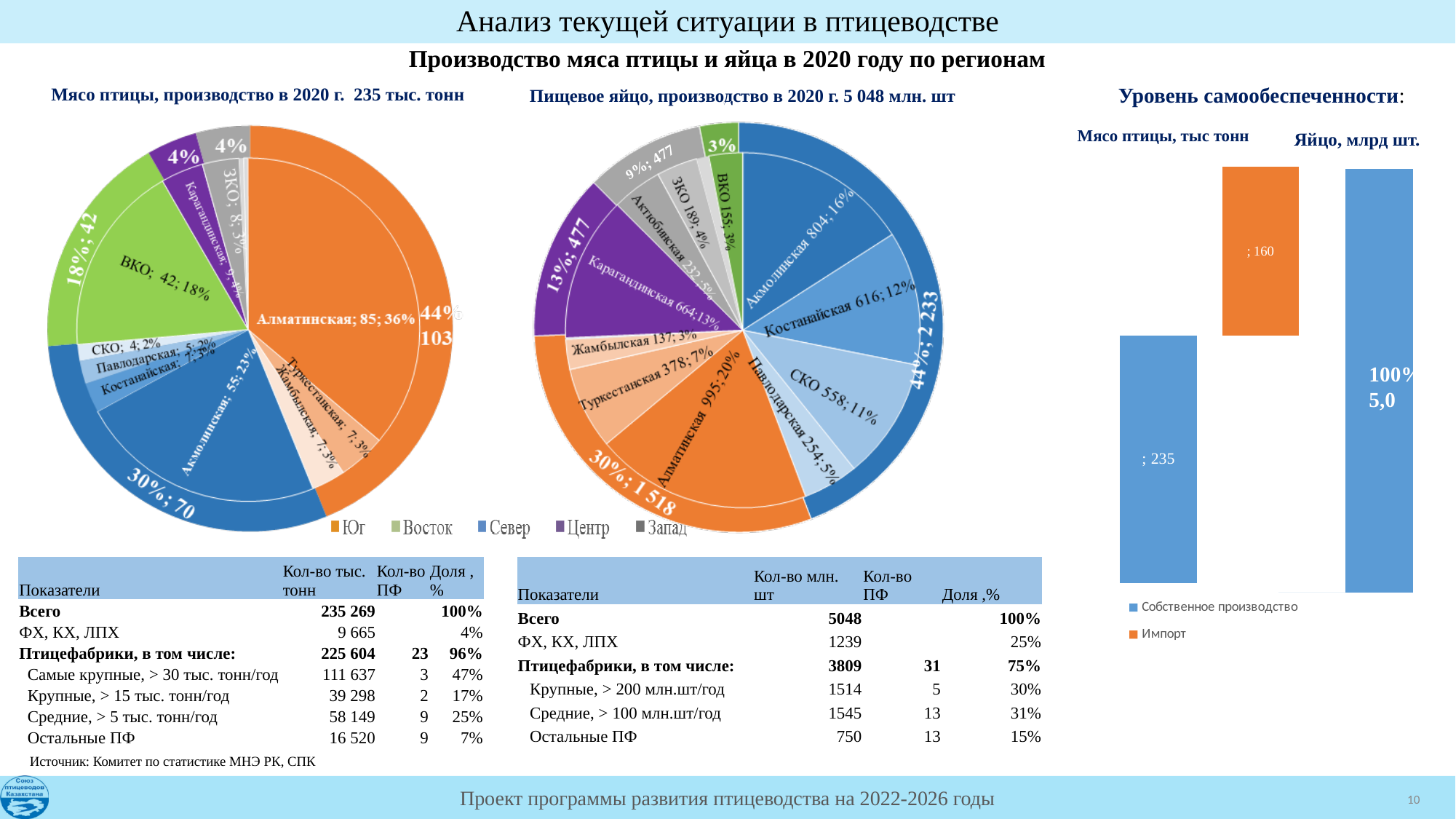
In the pie chart 'Мясо птицы, производство в 2020 г.', which region has the largest slice? Алматинская In the pie chart 'Мясо птицы, производство в 2020 г.', what is the value shown for ВКО? 42 In the pie chart 'Пищевое яйцо, производство в 2020 г.', what percentage share does Карагандинская have? 13% In the pie chart 'Мясо птицы, производство в 2020 г.', which is larger, Акмолинская or ВКО? Акмолинская In the pie chart 'Пищевое яйцо, производство в 2020 г.', which region has the smallest slice? Жамбылская In the pie chart 'Пищевое яйцо, производство в 2020 г.', what is the value shown for Алматинская? 995 In the bar chart 'Уровень самообеспеченности', what is the value of Импорт for Мясо птицы? 160 How many entries does the legend shared by the two pie charts list? 5 In the pie chart 'Мясо птицы, производство в 2020 г.', what is the difference between the values for Алматинская and Акмолинская? 30 In the pie chart 'Пищевое яйцо, производство в 2020 г.', what is the difference between the values for Акмолинская and Костанайская? 188 What kind of chart is 'Уровень самообеспеченности'? Bar chart In the pie chart 'Мясо птицы, производство в 2020 г.', what percentage share does Алматинская have? 36%